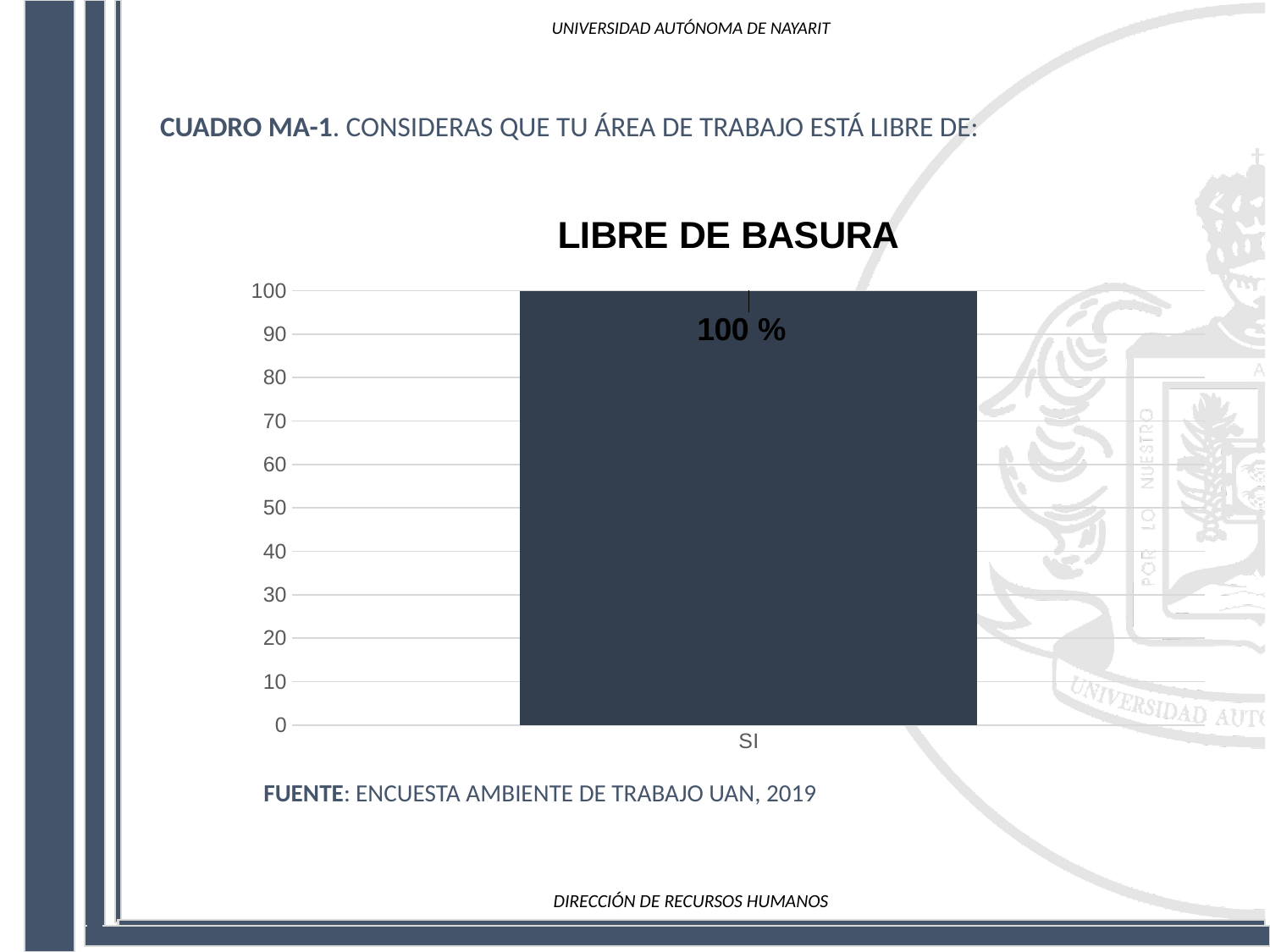
What is the highest value shown on the vertical axis of the chart? 100 What is the title of the chart? LIBRE DE BASURA How many categories are plotted in the LIBRE DE BASURA chart? 1 What kind of chart is shown on the slide? bar chart What is the label of the only category on the x axis? SI Is the value for SI greater or less than 50? greater What is the value for SI in the LIBRE DE BASURA chart? 100 %